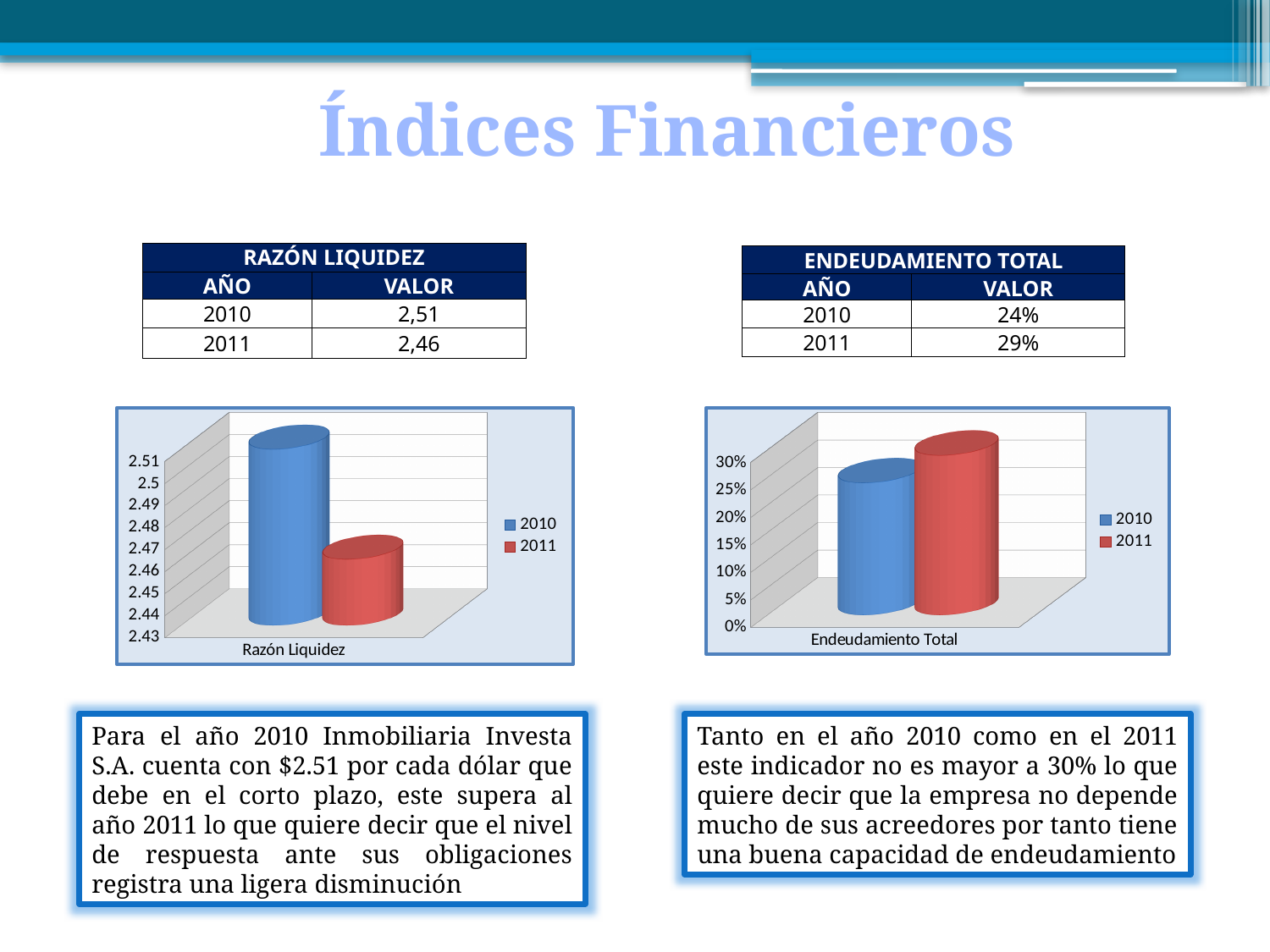
In the Endeudamiento Total chart, what is the difference between the 2011 and 2010 values? 5% In the Razón Liquidez chart, what is the value for 2010? 2.51 In the Endeudamiento Total chart, what is the value for 2010? 24% In the Endeudamiento Total chart, what is the value for 2011? 29% In the Razón Liquidez chart, is the value for 2011 greater or less than 2.5? less In the Razón Liquidez chart, what is the value for 2011? 2.46 What kind of chart is the left chart titled Razón Liquidez? bar chart In the Endeudamiento Total chart, what colour is the bar for 2011? red How many series does the legend of the Razón Liquidez chart list? 2 In the Endeudamiento Total chart, which year has the lower value? 2010 In the Endeudamiento Total chart, is the value for 2011 greater or less than 30%? less In the Razón Liquidez chart, which year has the higher value? 2010